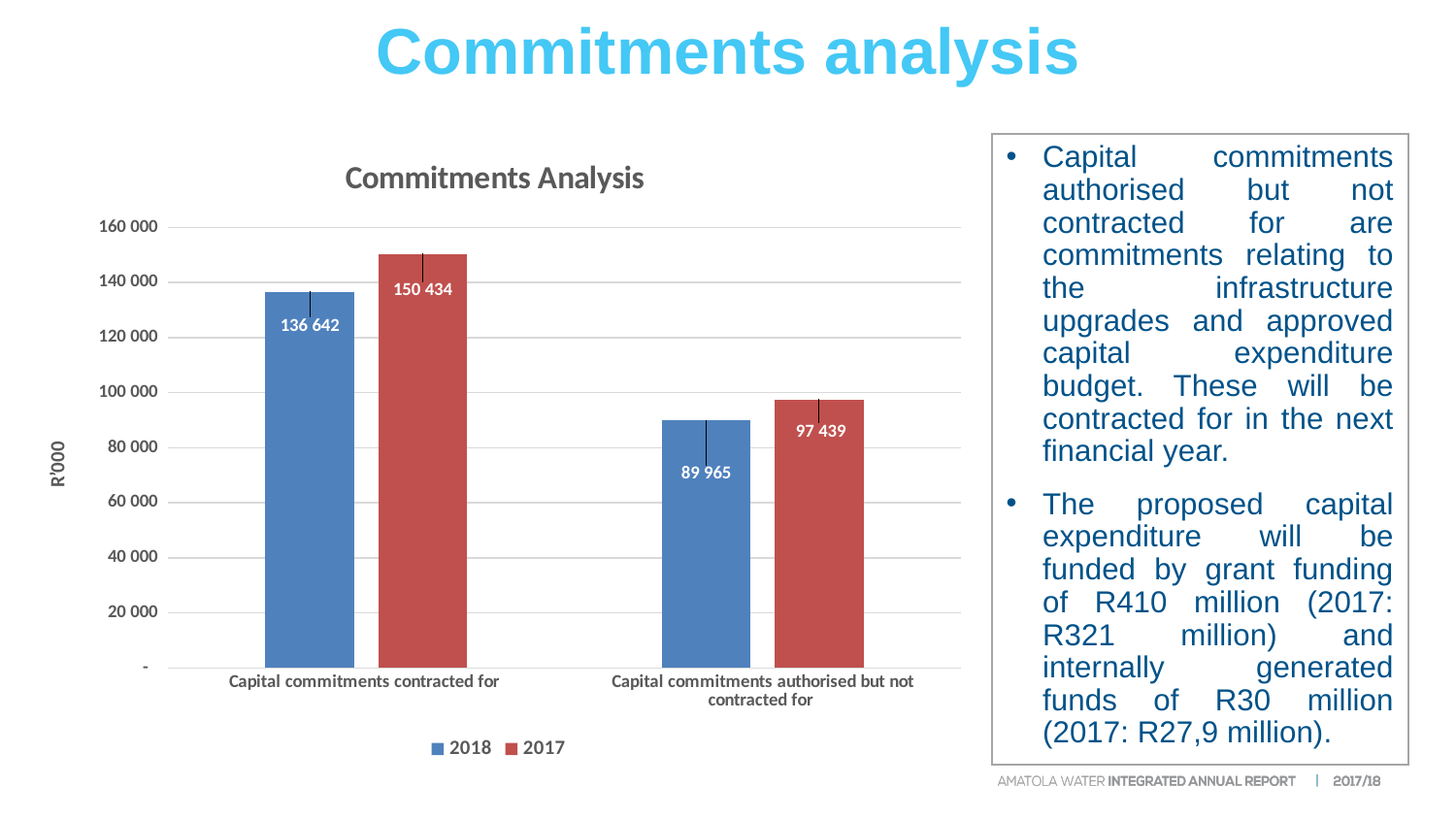
What is the 2018 value for Capital commitments authorised but not contracted for? 89 965 Which bar has the highest value in the chart? 2017, Capital commitments contracted for Which bar has the lowest value in the chart? 2018, Capital commitments authorised but not contracted for What is the 2017 value for Capital commitments authorised but not contracted for? 97 439 What is the 2018 value for Capital commitments contracted for? 136 642 How many categories are shown on the x axis? 2 What is the difference between the 2017 and 2018 values for Capital commitments contracted for? 13 792 How many series does the legend list? 2 What is the difference between the 2017 and 2018 values for Capital commitments authorised but not contracted for? 7 474 What type of chart is shown on the slide? Bar chart Is the 2017 value for Capital commitments contracted for greater or less than 140 000? greater For Capital commitments authorised but not contracted for, which year has the larger value, 2018 or 2017? 2017